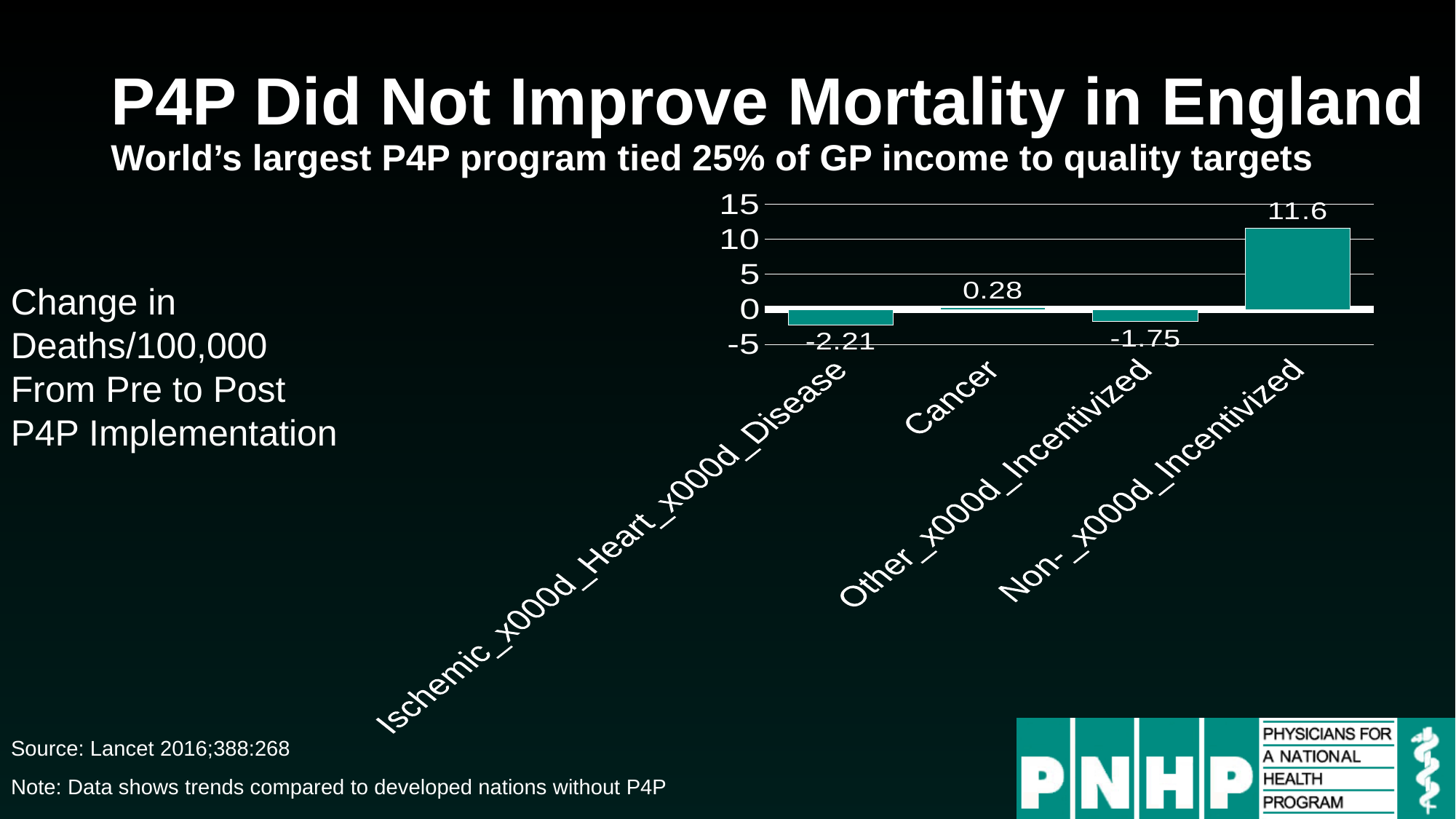
What kind of chart is shown on the slide? Bar chart How many categories are shown in the chart? 4 Is the value for Non-Incentivized greater or less than 10? greater What is the value for Non-Incentivized? 11.6 What is the value for Ischemic Heart Disease? -2.21 What is the value for Other Incentivized? -1.75 What is the difference between the values for Non-Incentivized and Cancer? 11.32 Which category has the highest value? Non-Incentivized What is the value for Cancer? 0.28 What is the title of the slide containing the chart? P4P Did Not Improve Mortality in England Which category has the lowest value? Ischemic Heart Disease Which is larger, the value for Cancer or the value for Other Incentivized? Cancer